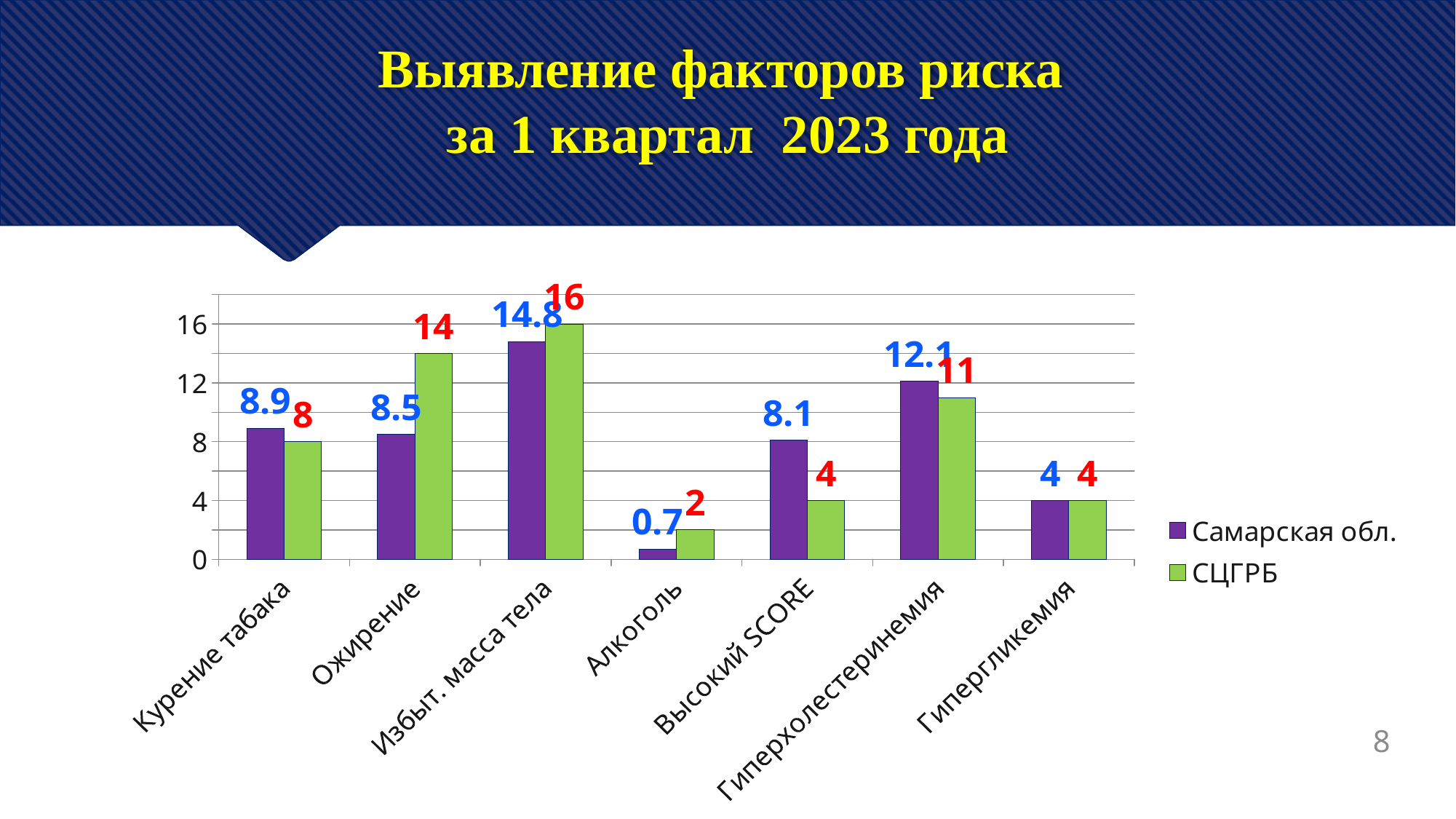
What kind of chart is shown on the slide? Bar chart What is the value for Самарская обл. in the Гиперхолестеринемия category? 12.1 What is the value for СЦГРБ in the Гипергликемия category? 4 Which category has the lowest value for Самарская обл.? Алкоголь What colour are the bars for the СЦГРБ series? Green What is the value for Самарская обл. in the Курение табака category? 8.9 What is the value for СЦГРБ in the Ожирение category? 14 Which category has the highest value for СЦГРБ? Избыт. масса тела How many categories are shown on the x axis? 7 What is the difference between the Самарская обл. and СЦГРБ values in the Высокий SCORE category? 4.1 Which series has the larger value in the Ожирение category, Самарская обл. or СЦГРБ? СЦГРБ How many series does the legend list? 2